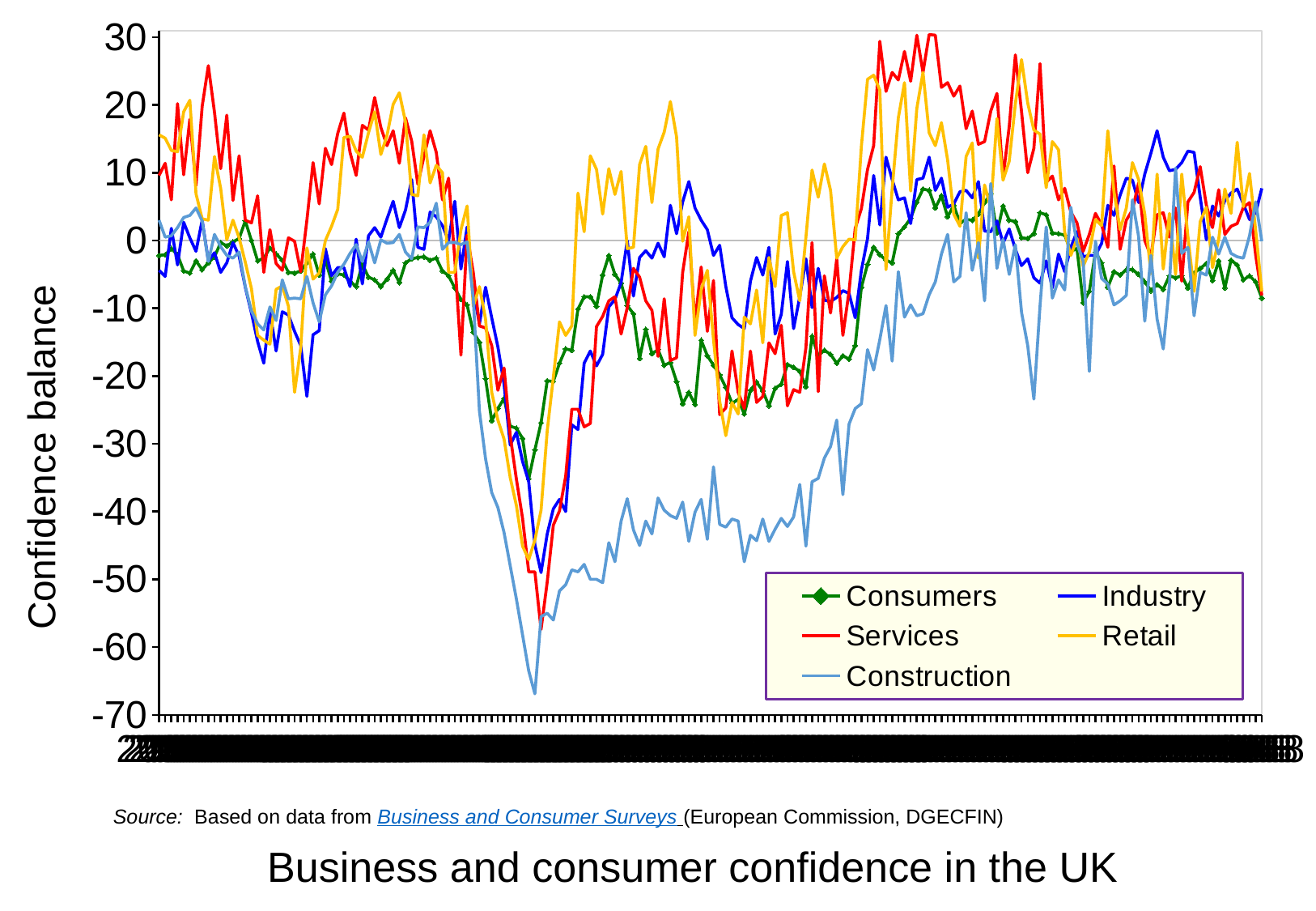
What is the title of the chart? Business and consumer confidence in the UK How many series does the legend list? 5 What is the label on the vertical axis? Confidence balance Which series reaches the highest value on the chart? Services Is the lowest value reached by the Construction series greater or less than -60? less Is the lowest value reached by the Consumers series greater or less than -40? greater Which series reaches the lowest value on the chart? Construction Is the lowest value reached by the Industry series greater or less than -40? less What kind of chart is shown on the slide? line chart